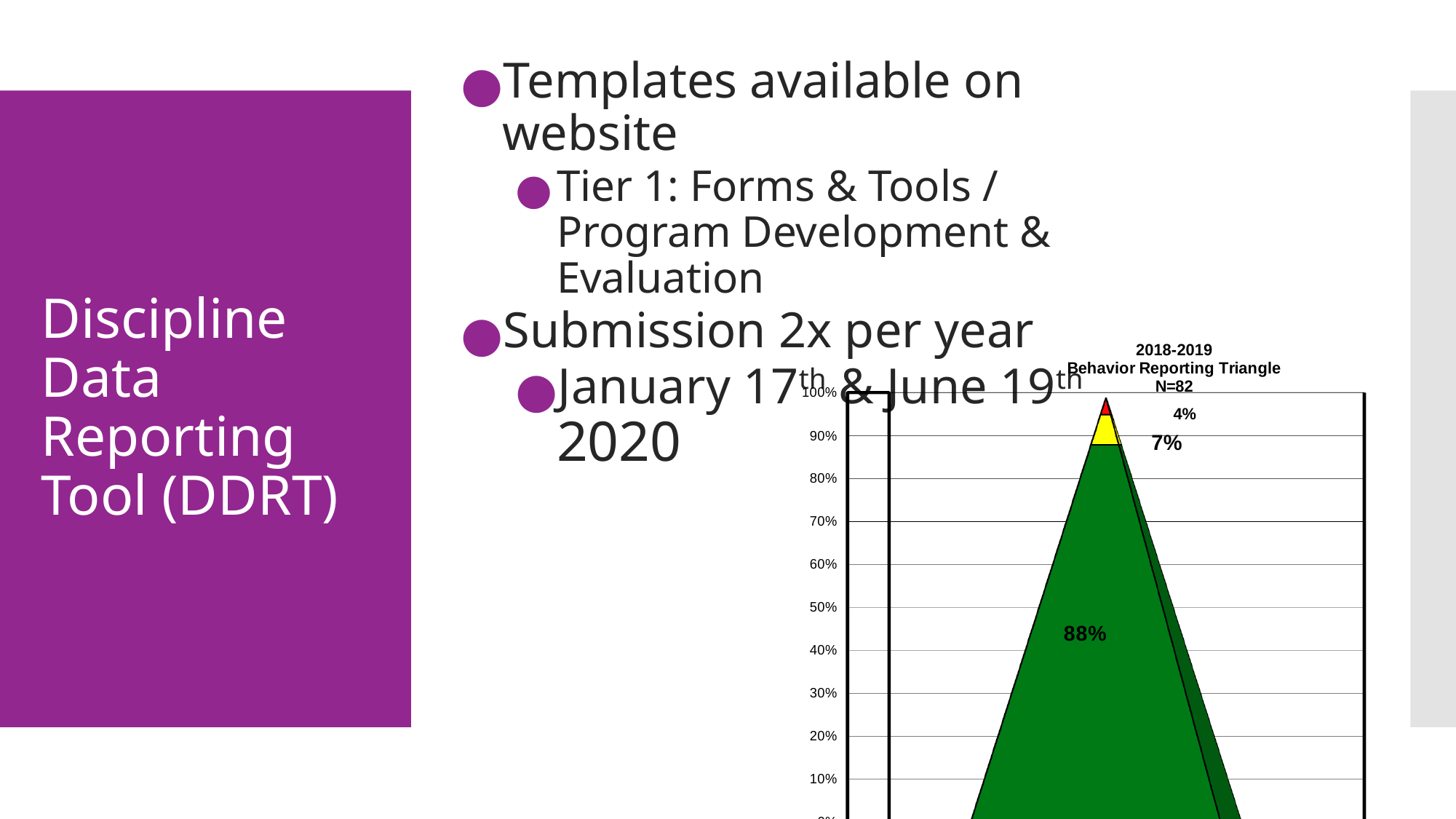
What is the difference between the green section's value and the yellow section's value in the triangle chart? 81% What is the N value stated in the chart title? N=82 What is the difference between the yellow section's value and the red section's value in the triangle chart? 3% What value is labelled on the green section of the triangle chart? 88% What value is labelled on the yellow section of the triangle chart? 7% Is the yellow section's value larger or smaller than the red section's value in the triangle chart? larger How many labelled sections does the triangle chart have? 3 What value is labelled on the red section at the top of the triangle chart? 4% Which section of the triangle chart has the largest value? the green section (88%) Is the green section's value greater or less than 80% in the triangle chart? greater Which section of the triangle chart has the smallest value? the red section (4%) What is the title of the chart on the slide? 2018-2019 Behavior Reporting Triangle N=82